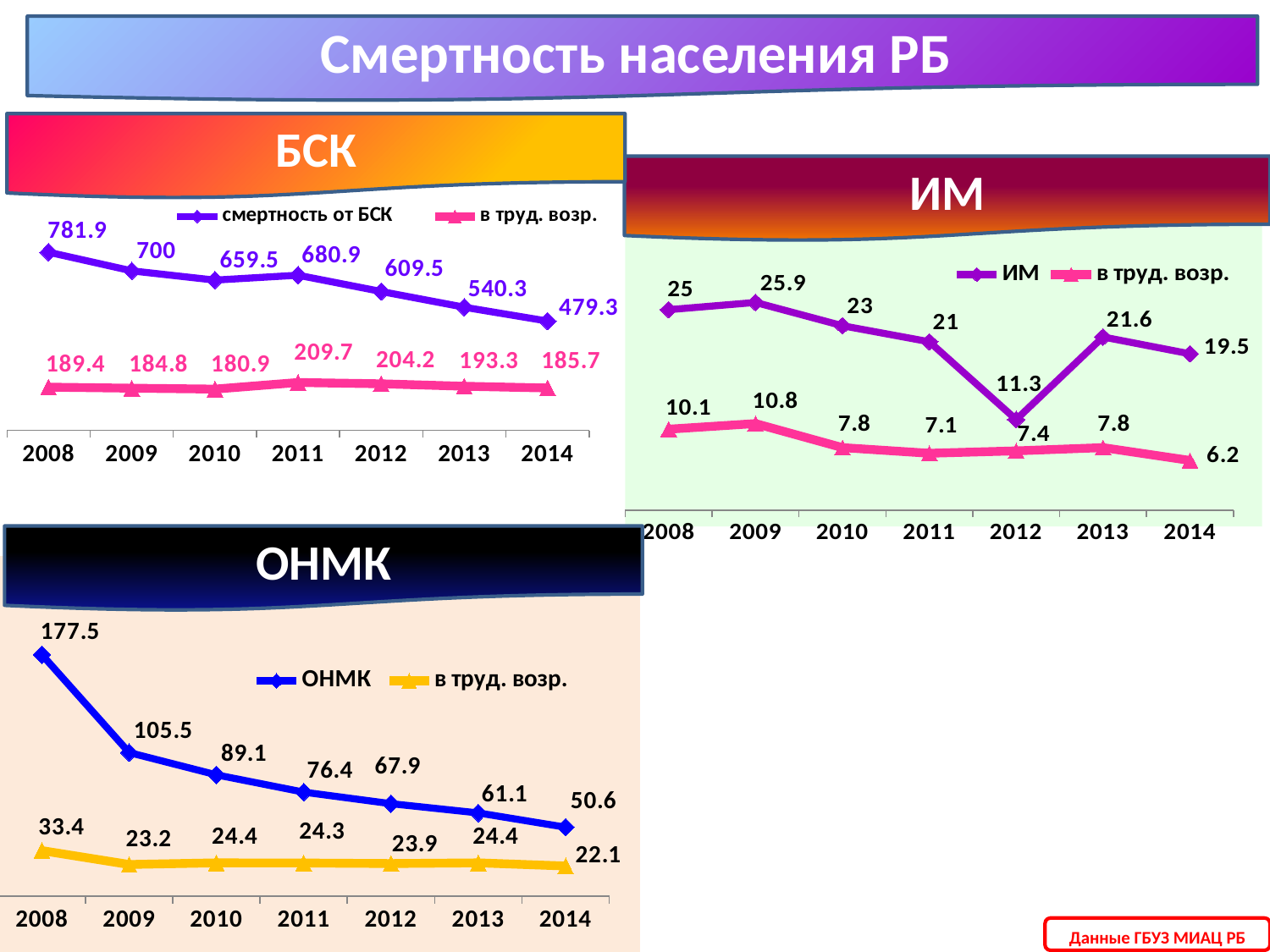
In the ОНМК chart, what is the value of ОНМК in 2010? 89.1 In the БСК chart, what is the difference between смертность от БСК in 2008 and in 2014? 302.6 What type of chart is the БСК chart? line chart In the ОНМК chart, what is the difference between ОНМК and в труд. возр. in 2008? 144.1 In the ИМ chart, what is the value of в труд. возр. in 2014? 6.2 In the ОНМК chart, which is larger: в труд. возр. in 2008 or in 2014? 2008 In the БСК chart, what is the value of в труд. возр. in 2011? 209.7 In the БСК chart, what is the value of смертность от БСК in 2008? 781.9 In the ИМ chart, which year has the highest value for the ИМ series? 2009 In the ОНМК chart, does the ОНМК series rise or fall from 2008 to 2014? fall How many years are shown on the x axis of the ИМ chart? 7 In the ИМ chart, which year has the lowest value for the ИМ series? 2012